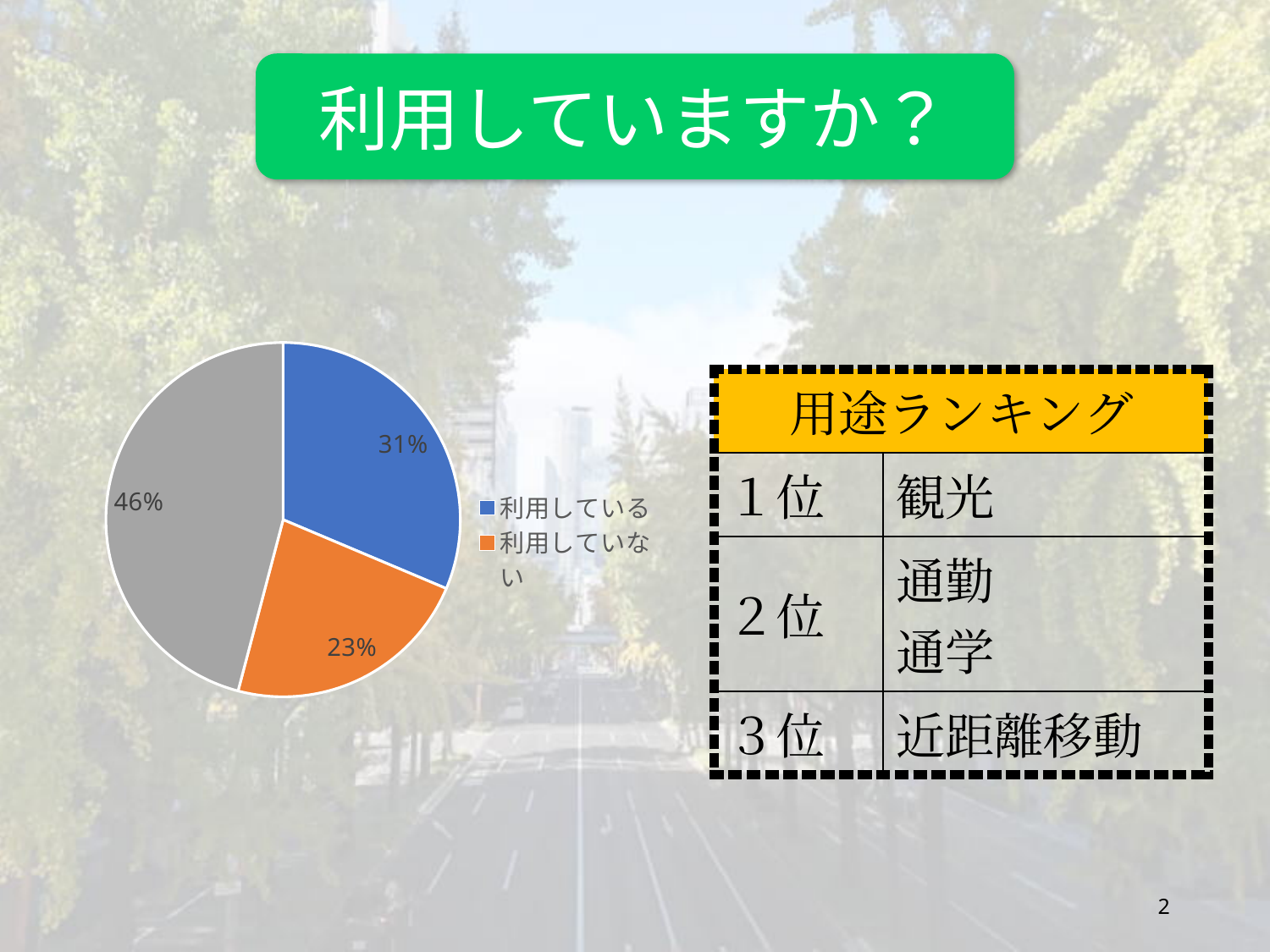
Which slice of the pie chart is the smallest? 利用していない (23%) What colour is the 利用していない slice in the pie chart? Orange What share of the pie does the 利用している slice represent? 31% How many slices does the pie chart have? 3 What is the difference in percentage points between the 利用している slice and the 利用していない slice? 8 percentage points What percentage is shown on the gray slice of the pie chart? 46% Which of the two legend categories, 利用している or 利用していない, has the larger share of the pie? 利用している What type of chart is shown on the slide? Pie chart What percentage of the pie chart is labelled 利用している? 31% What percentage of the pie chart is labelled 利用していない? 23% How many entries does the pie chart's legend list? 2 What colour is the 利用している slice in the pie chart? Blue